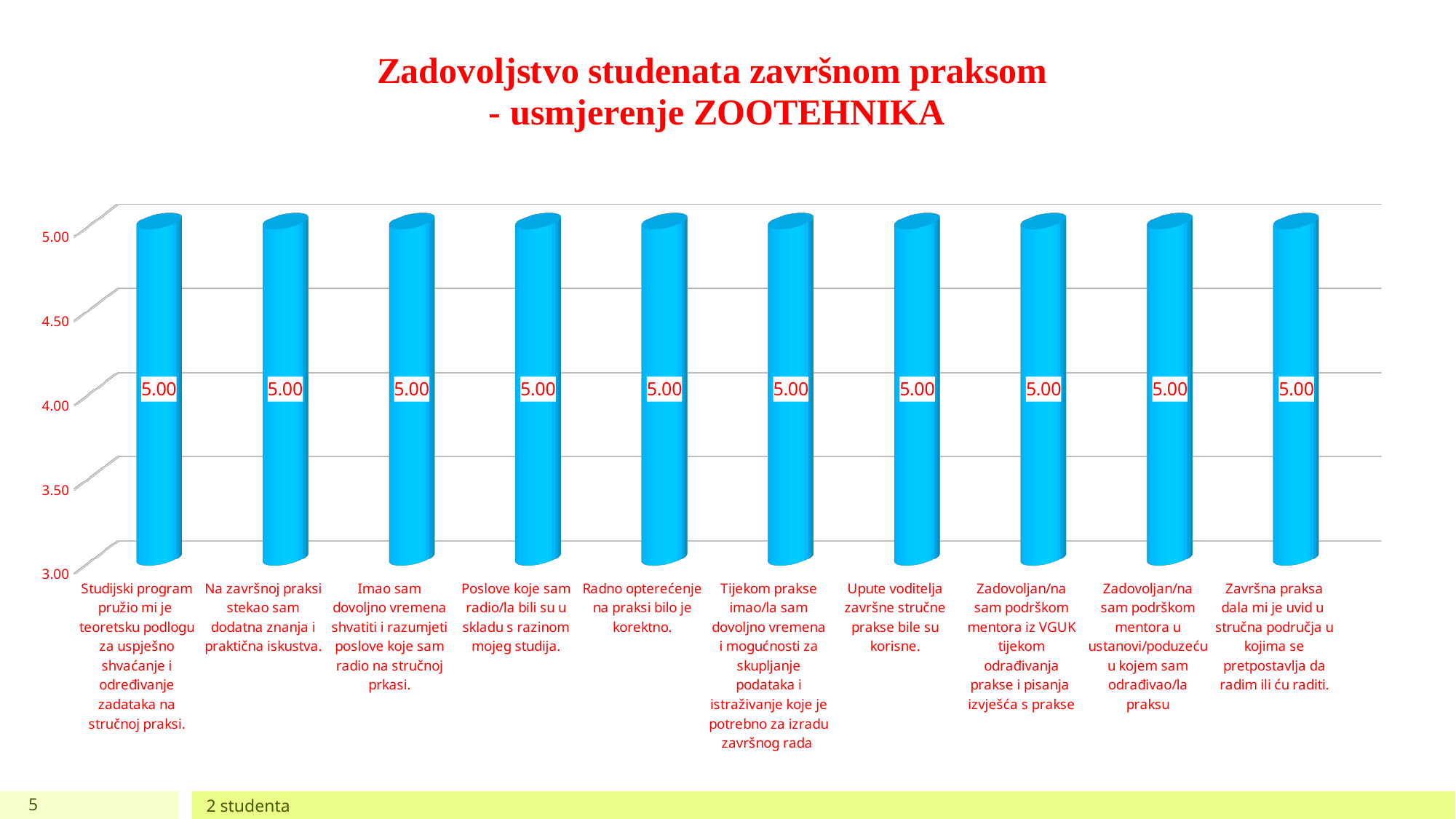
Do the values rise, fall, or stay the same across the categories along the x axis? Stay the same What is the value for "Na završnoj praksi stekao sam dodatna znanja i praktična iskustva."? 5.00 What is the value for "Radno opterećenje na praksi bilo je korektno."? 5.00 What kind of chart is shown on the slide? Bar chart What is the difference between the value for "Radno opterećenje na praksi bilo je korektno." and the value for "Upute voditelja završne stručne prakse bile su korisne."? 0.00 Is the value for "Poslove koje sam radio/la bili su u skladu s razinom mojeg studija." greater or less than 4.00? greater What is the value for "Završna praksa dala mi je uvid u stručna područja u kojima se pretpostavlja da radim ili ću raditi."? 5.00 Is the value for "Zadovoljan/na sam podrškom mentora iz VGUK tijekom odrađivanja prakse i pisanja izvješća s prakse" larger than, smaller than, or equal to the value for "Zadovoljan/na sam podrškom mentora u ustanovi/poduzeću u kojem sam odrađivao/la praksu"? Equal What is the value for "Upute voditelja završne stručne prakse bile su korisne."? 5.00 What is the title of the chart? Zadovoljstvo studenata završnom praksom - usmjerenje ZOOTEHNIKA How many students does the note at the bottom of the slide say took part? 2 studenta How many categories (bars) are shown in the chart? 10